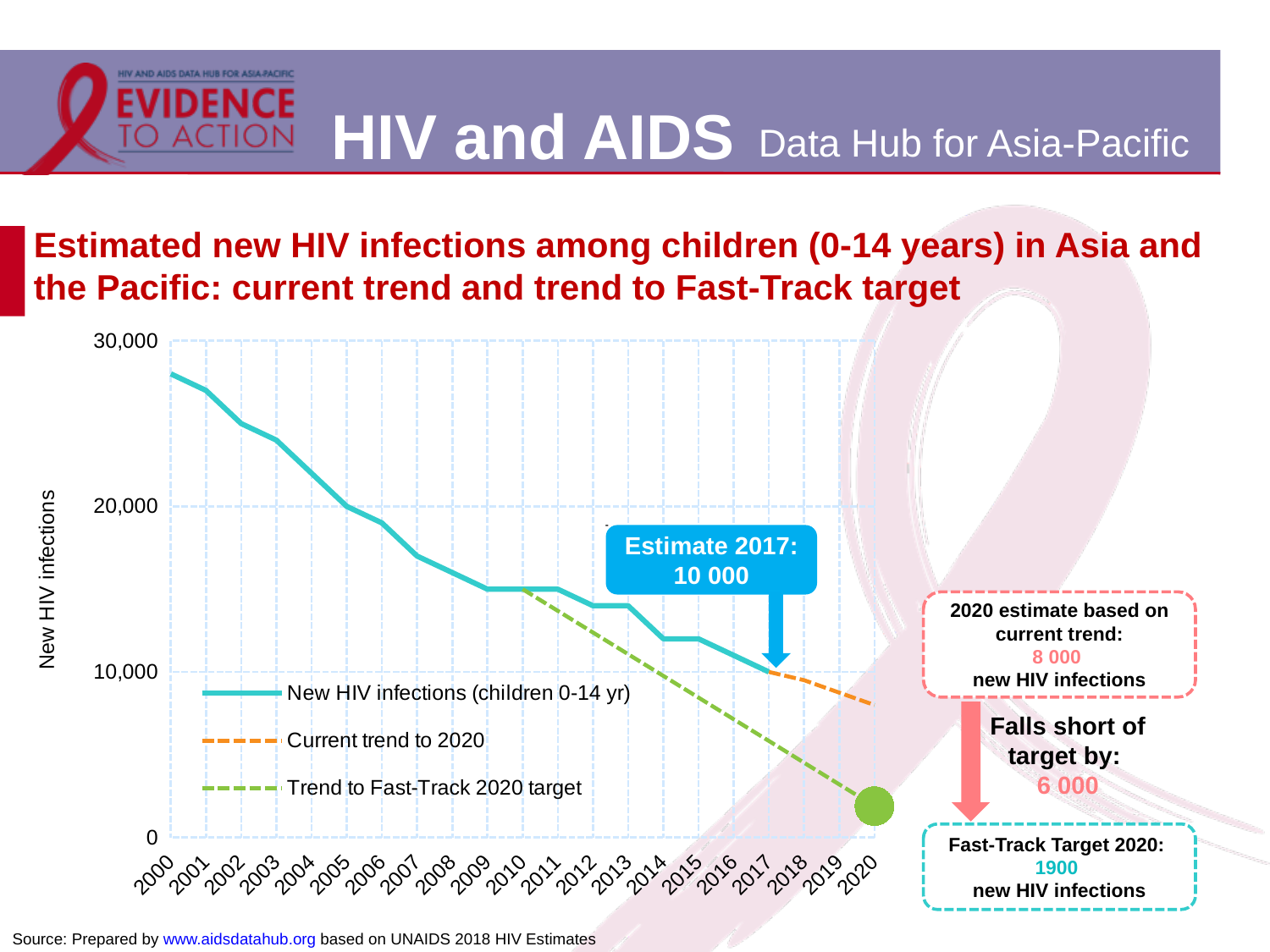
Which year has the larger number of new HIV infections, 2000 or 2017? 2000 Is the value for new HIV infections in 2010 greater or less than 20,000? less How many series does the chart legend list? 3 Do new HIV infections among children rise or fall from 2000 to 2017? fall By how much does the 2020 estimate based on the current trend fall short of the Fast-Track target? 6 000 What is the label on the y axis of the chart? New HIV infections What is the Fast-Track Target for new HIV infections in 2020? 1900 What is the 2020 estimate of new HIV infections based on the current trend? 8 000 Is the value for new HIV infections in 2000 greater or less than 20,000? greater How many years are labelled on the x axis? 21 What kind of chart is shown on the slide? line chart What is the estimated number of new HIV infections among children in 2017? 10 000